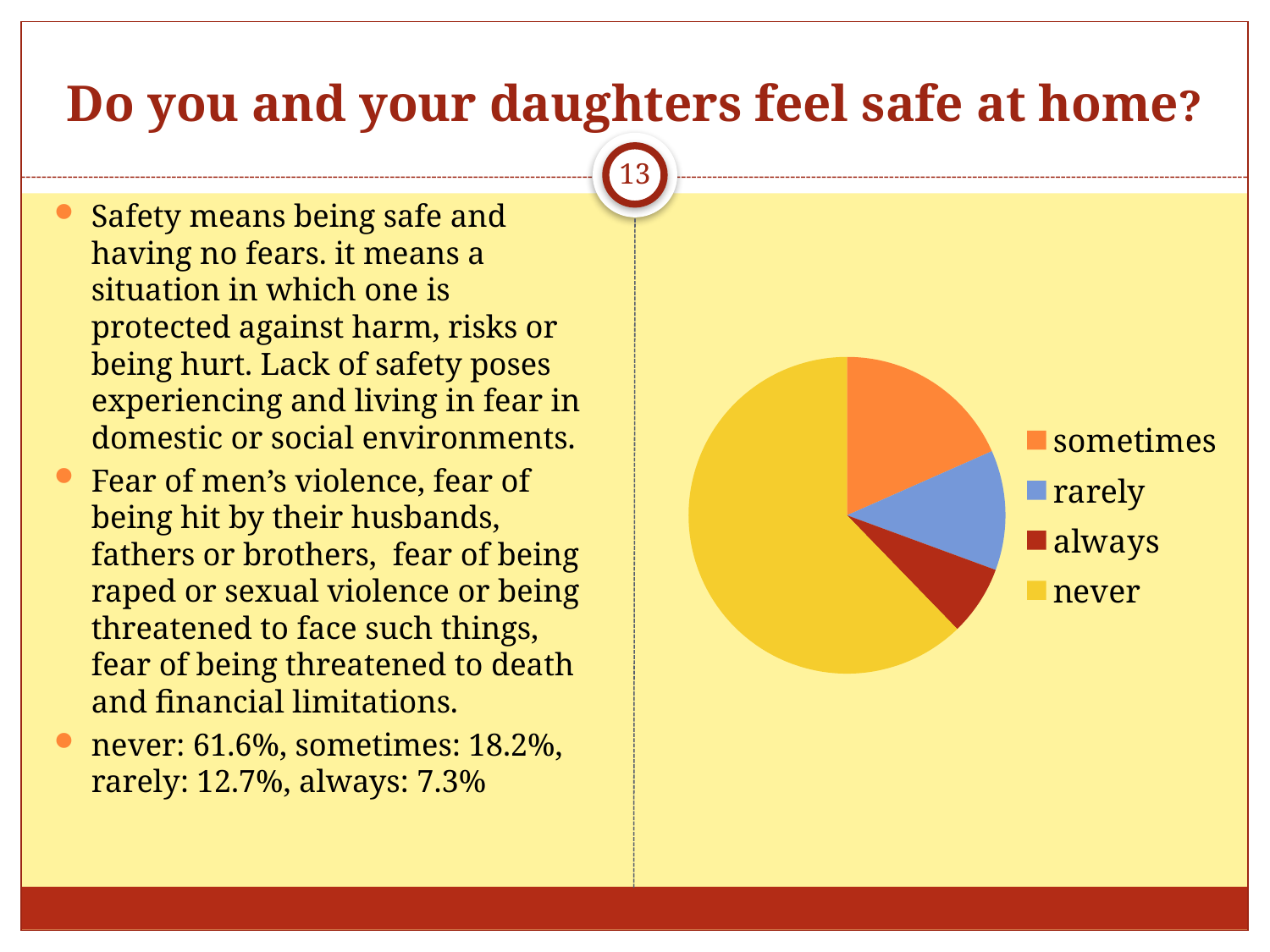
Which slice is larger, 'sometimes' or 'rarely'? sometimes What share of the pie does the 'never' slice represent? 61.6% What is the difference between the 'never' share and the 'sometimes' share? 43.4% What share of the pie does the 'sometimes' slice represent? 18.2% What is the difference between the 'rarely' share and the 'always' share? 5.4% Which colour represents 'never' in the pie chart? yellow What share of the pie does the 'rarely' slice represent? 12.7% Which category has the largest slice of the pie chart? never What kind of chart is shown on the slide? pie chart How many slices does the pie chart have? 4 Which category has the smallest slice of the pie chart? always